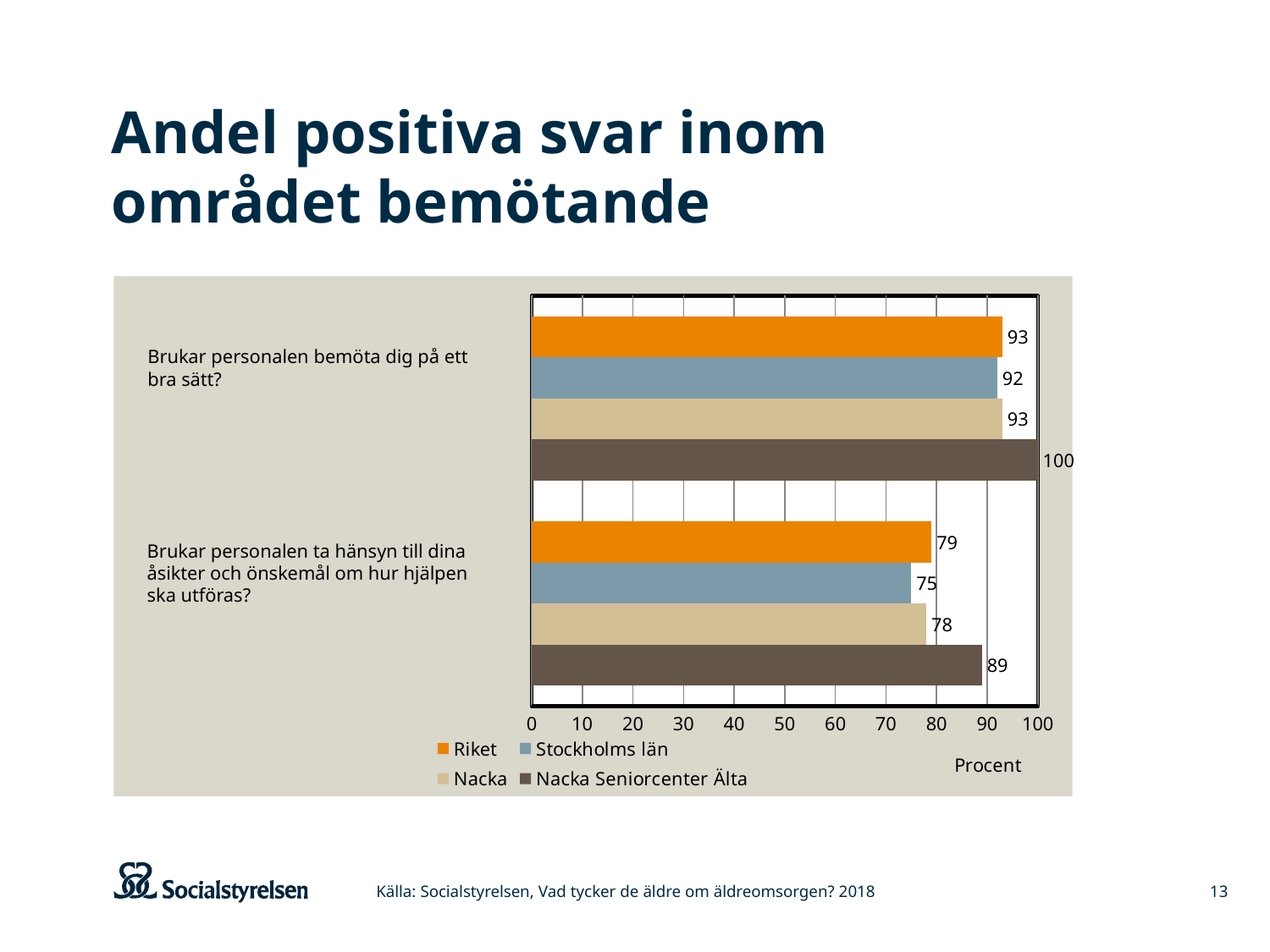
What is the value for Stockholms län for the question "Brukar personalen ta hänsyn till dina åsikter och önskemål om hur hjälpen ska utföras?"? 75 What is the difference between the Nacka Seniorcenter Älta value and the Riket value for the question "Brukar personalen ta hänsyn till dina åsikter och önskemål om hur hjälpen ska utföras?"? 10 What is the difference between the Nacka Seniorcenter Älta value and the Stockholms län value for the question "Brukar personalen bemöta dig på ett bra sätt?"? 8 What is the value for Riket for the question "Brukar personalen ta hänsyn till dina åsikter och önskemål om hur hjälpen ska utföras?"? 79 What is the value for Nacka for the question "Brukar personalen bemöta dig på ett bra sätt?"? 93 What kind of chart is shown on the slide? Bar chart For the question "Brukar personalen ta hänsyn till dina åsikter och önskemål om hur hjälpen ska utföras?", which is larger: the value for Riket or the value for Nacka? Riket How many series does the legend list? 4 Which series has the highest value for the question "Brukar personalen ta hänsyn till dina åsikter och önskemål om hur hjälpen ska utföras?"? Nacka Seniorcenter Älta Which series has the lowest value for the question "Brukar personalen ta hänsyn till dina åsikter och önskemål om hur hjälpen ska utföras?"? Stockholms län What is the label on the horizontal axis of the chart? Procent What is the value for Nacka Seniorcenter Älta for the question "Brukar personalen bemöta dig på ett bra sätt?"? 100